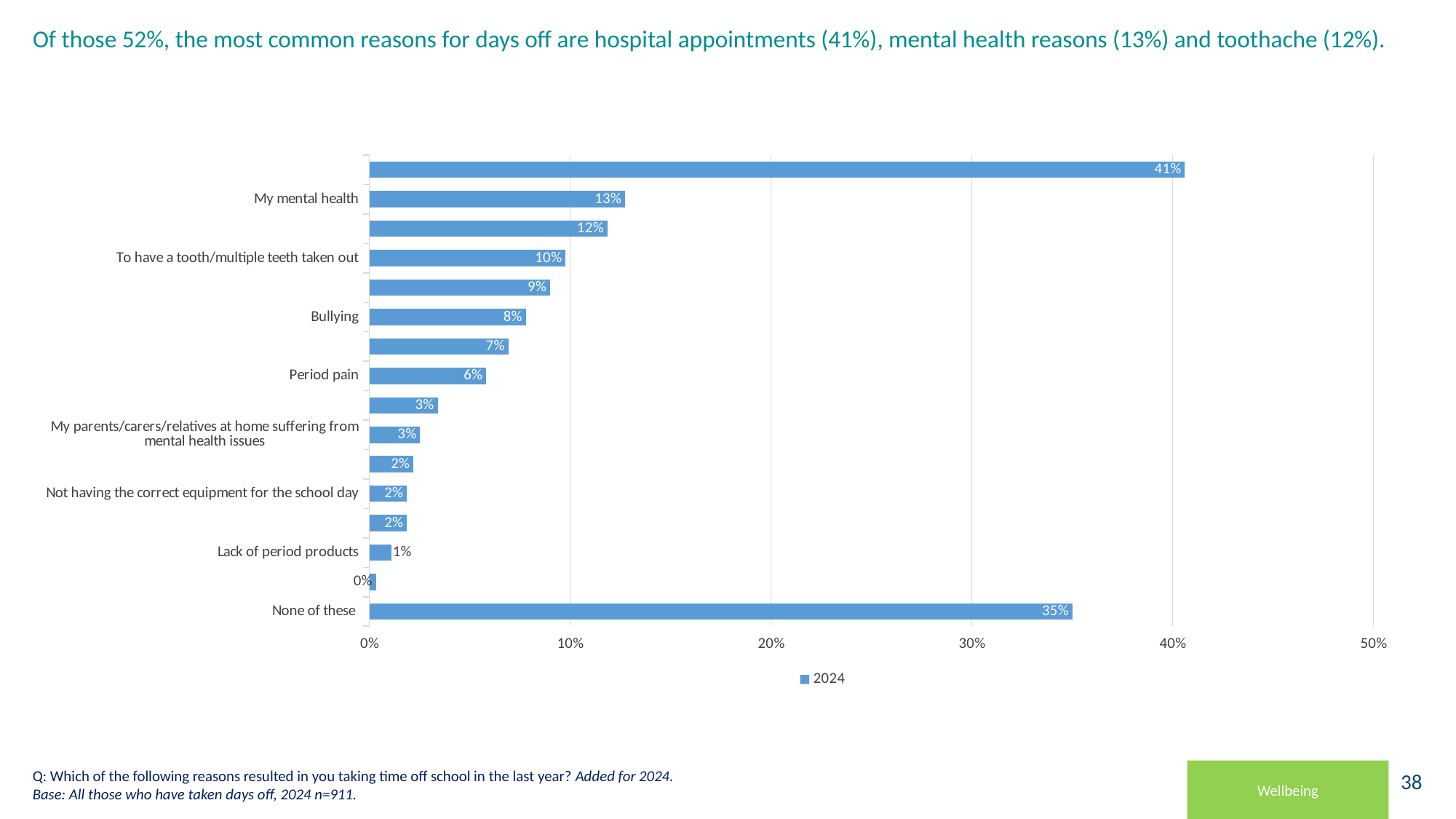
How many bars are plotted in the chart? 16 What is the difference between the values for My mental health and Bullying? 5% What is the value for To have a tooth/multiple teeth taken out? 10% What is the value for Bullying? 8% What is the value for Period pain? 6% Which is larger, the value for Bullying or the value for Period pain? Bullying Is the value for None of these greater or less than 30%? greater What kind of chart is shown on the slide? bar chart What is the value for Lack of period products? 1% What is the value for My mental health? 13% What is the difference between the values for None of these and My mental health? 22% What is the value for None of these? 35%